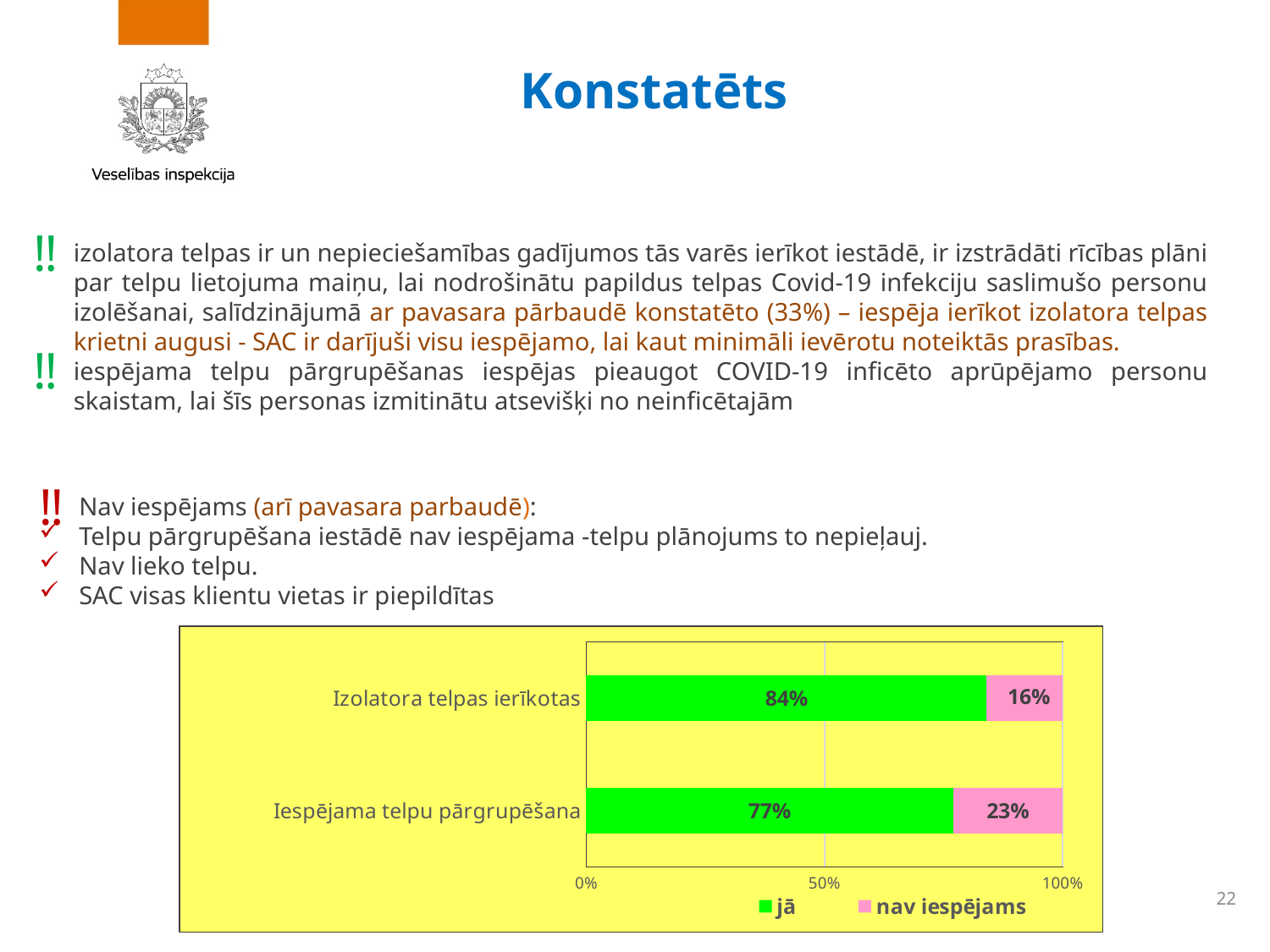
What is the value of "nav iespējams" for "Izolatora telpas ierīkotas"? 16% What is the value of "nav iespējams" for "Iespējama telpu pārgrupēšana"? 23% Which category has the higher "jā" value? Izolatora telpas ierīkotas Is the "nav iespējams" value for "Iespējama telpu pārgrupēšana" larger or smaller than the "nav iespējams" value for "Izolatora telpas ierīkotas"? larger Is the "jā" value for "Iespējama telpu pārgrupēšana" greater or less than 50%? greater What is the difference between the "jā" values for "Izolatora telpas ierīkotas" and "Iespējama telpu pārgrupēšana"? 7% What kind of chart is shown on the slide? Stacked bar chart How many series does the legend list? 2 How many categories are shown in the chart? 2 What is the value of "jā" for "Iespējama telpu pārgrupēšana"? 77% What is the value of "jā" for "Izolatora telpas ierīkotas"? 84% Which category has the lower "nav iespējams" value? Izolatora telpas ierīkotas